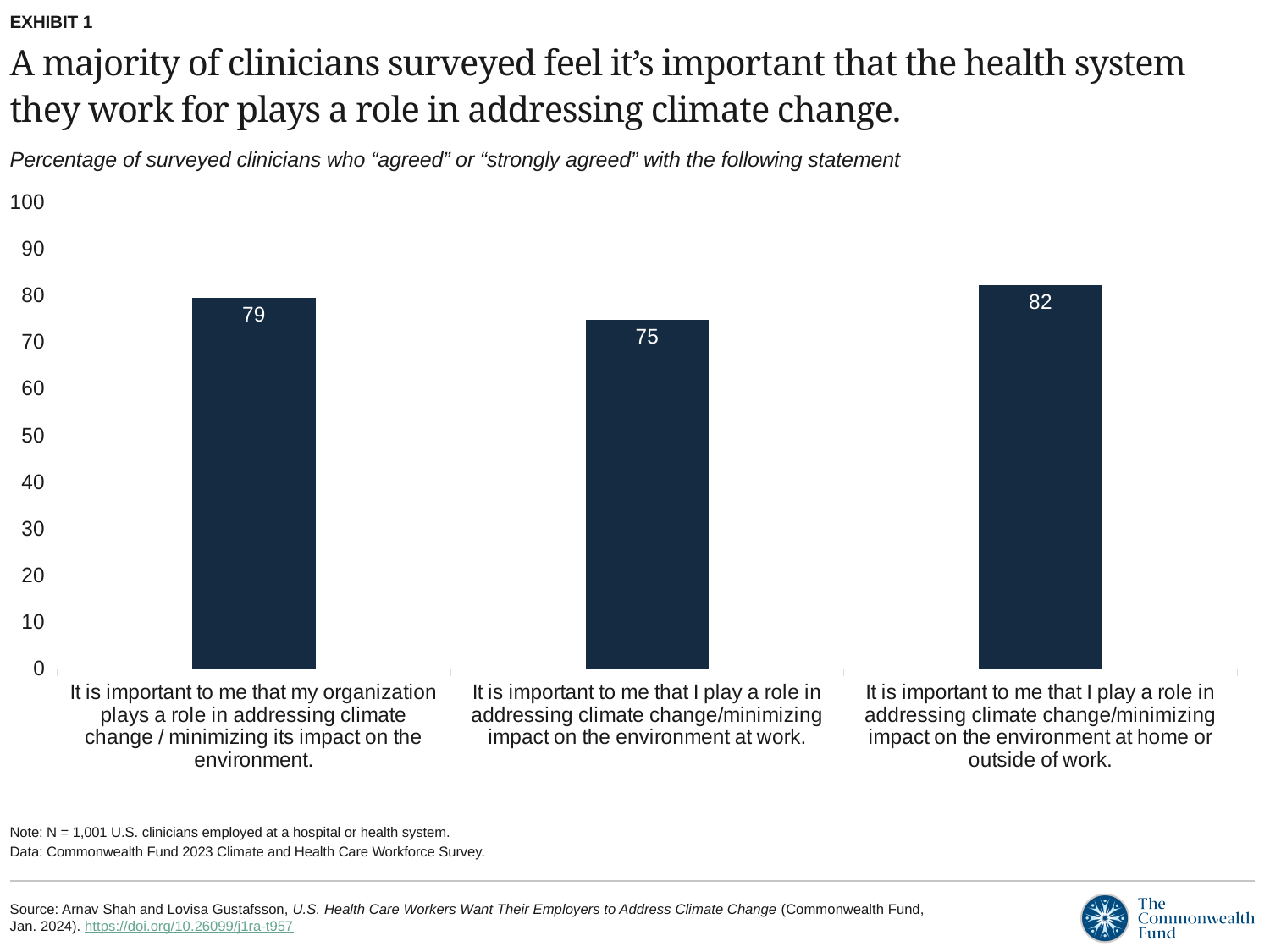
Which is larger: the percentage agreeing that their organization should play a role, or the percentage agreeing that they should play a role at work? The percentage agreeing that their organization should play a role Is the value for the statement about playing a role at home or outside of work greater or less than 80? greater What type of chart is shown on the slide? Bar chart How many statements (bars) are shown in the chart? 3 What percentage of surveyed clinicians agreed or strongly agreed that it is important that they play a role in addressing climate change/minimizing impact on the environment at home or outside of work? 82 What percentage of surveyed clinicians agreed or strongly agreed that it is important that they play a role in addressing climate change/minimizing impact on the environment at work? 75 What is the difference in percentage points between the statement about playing a role at home or outside of work and the statement about playing a role at work? 7 Which statement had the lowest percentage of clinicians agreeing or strongly agreeing? It is important to me that I play a role in addressing climate change/minimizing impact on the environment at work. What percentage of surveyed clinicians agreed or strongly agreed that it is important that their organization plays a role in addressing climate change / minimizing its impact on the environment? 79 What is the maximum value shown on the vertical axis of the chart? 100 What is the difference in percentage points between the statement about the organization playing a role and the statement about playing a role at work? 4 Which statement had the highest percentage of clinicians agreeing or strongly agreeing? It is important to me that I play a role in addressing climate change/minimizing impact on the environment at home or outside of work.